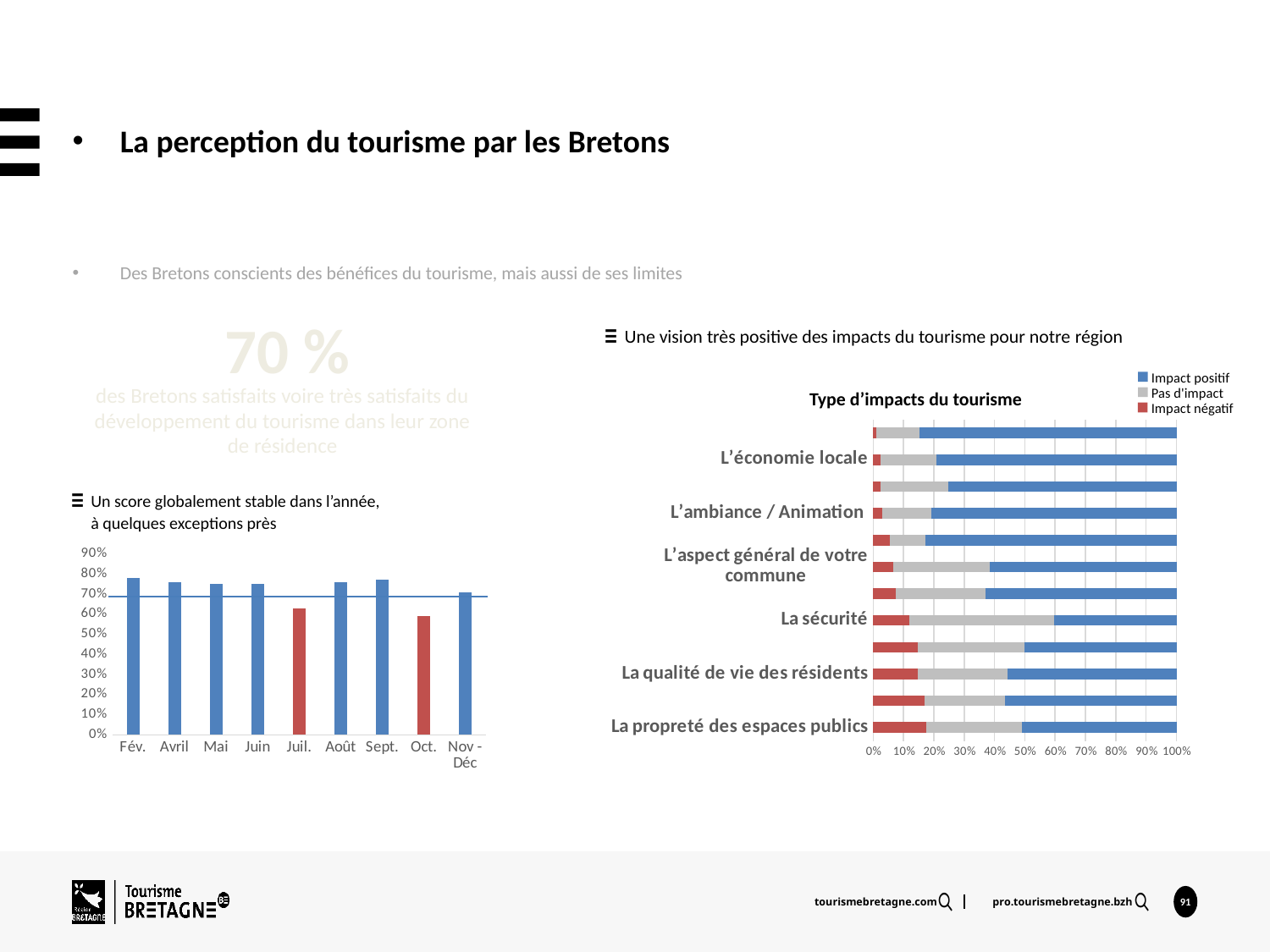
In the left chart of monthly scores, which month has the lowest value? Oct. In the left chart of monthly scores, is the value for Fév. greater or less than 70%? greater What kind of chart is the left chart showing monthly scores from Fév. to Nov - Déc? bar chart In the 'Type d'impacts du tourisme' chart, is the 'Impact positif' value for L'économie locale greater or less than 70%? greater In the 'Type d'impacts du tourisme' chart, which colour represents 'Impact négatif'? red In the left chart of monthly scores, which is larger, the value for Avril or the value for Juil.? Avril How many series does the legend of the 'Type d'impacts du tourisme' chart list? 3 What kind of chart is the 'Type d'impacts du tourisme' chart? bar chart In the left chart of monthly scores, is the value for Juil. greater or less than 70%? less In the left chart of monthly scores, how many months or periods are shown on the x axis? 9